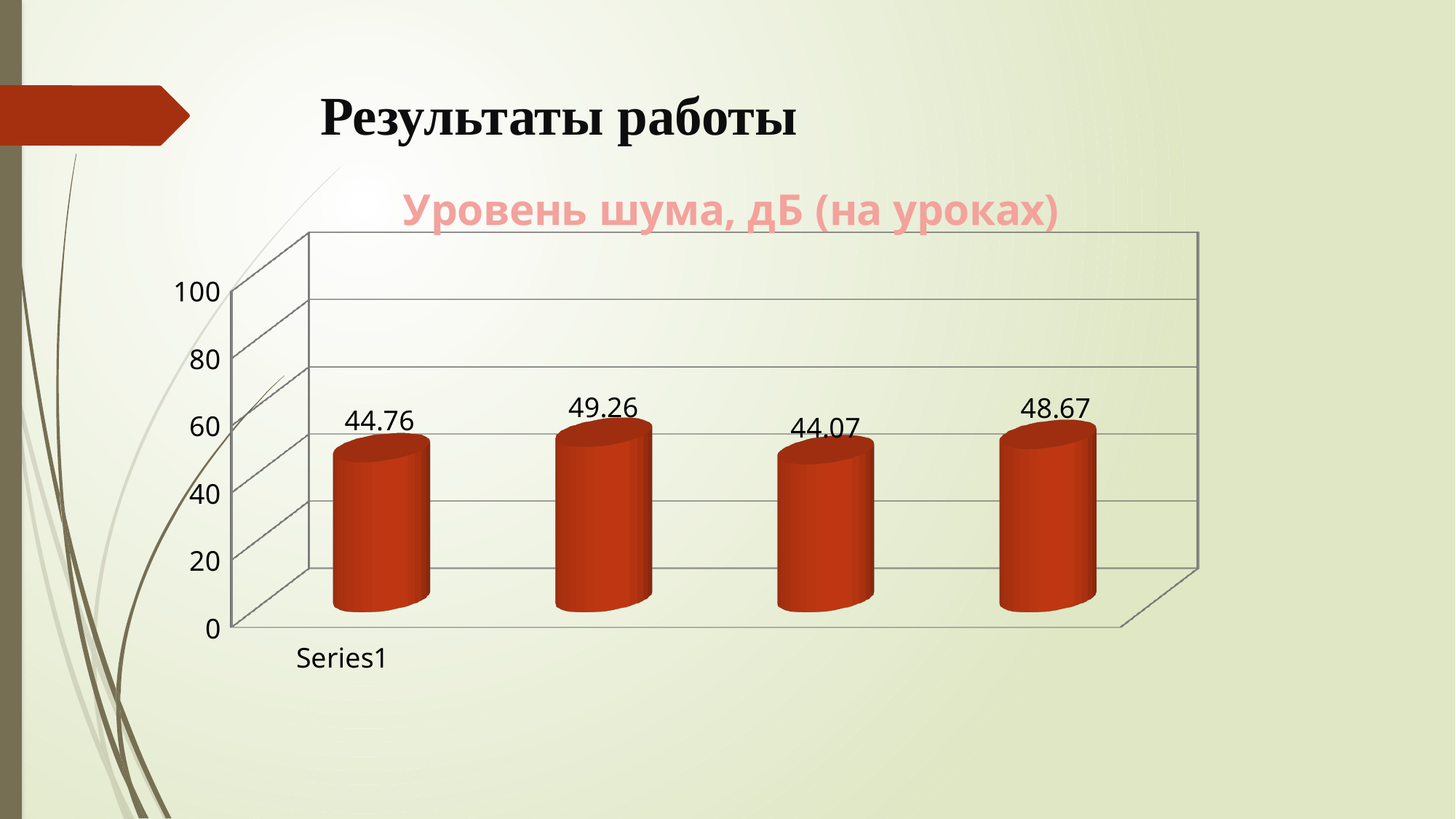
Which is larger, the value of the first bar or the value of the fourth bar? The fourth bar (48.67) Is the value of the second bar greater or less than 40? greater What is the value shown on the fourth (rightmost) bar? 48.67 What is the difference between the highest value (49.26) and the lowest value (44.07)? 5.19 What is the value shown on the first (leftmost) bar? 44.76 What is the title of the chart? Уровень шума, дБ (на уроках) What kind of chart is shown on the slide? Bar chart What is the value shown on the third bar from the left? 44.07 How many bars are plotted in the chart? 4 Which bar has the highest value? The second bar (49.26) Which bar has the lowest value? The third bar (44.07) What is the value shown on the second bar from the left? 49.26